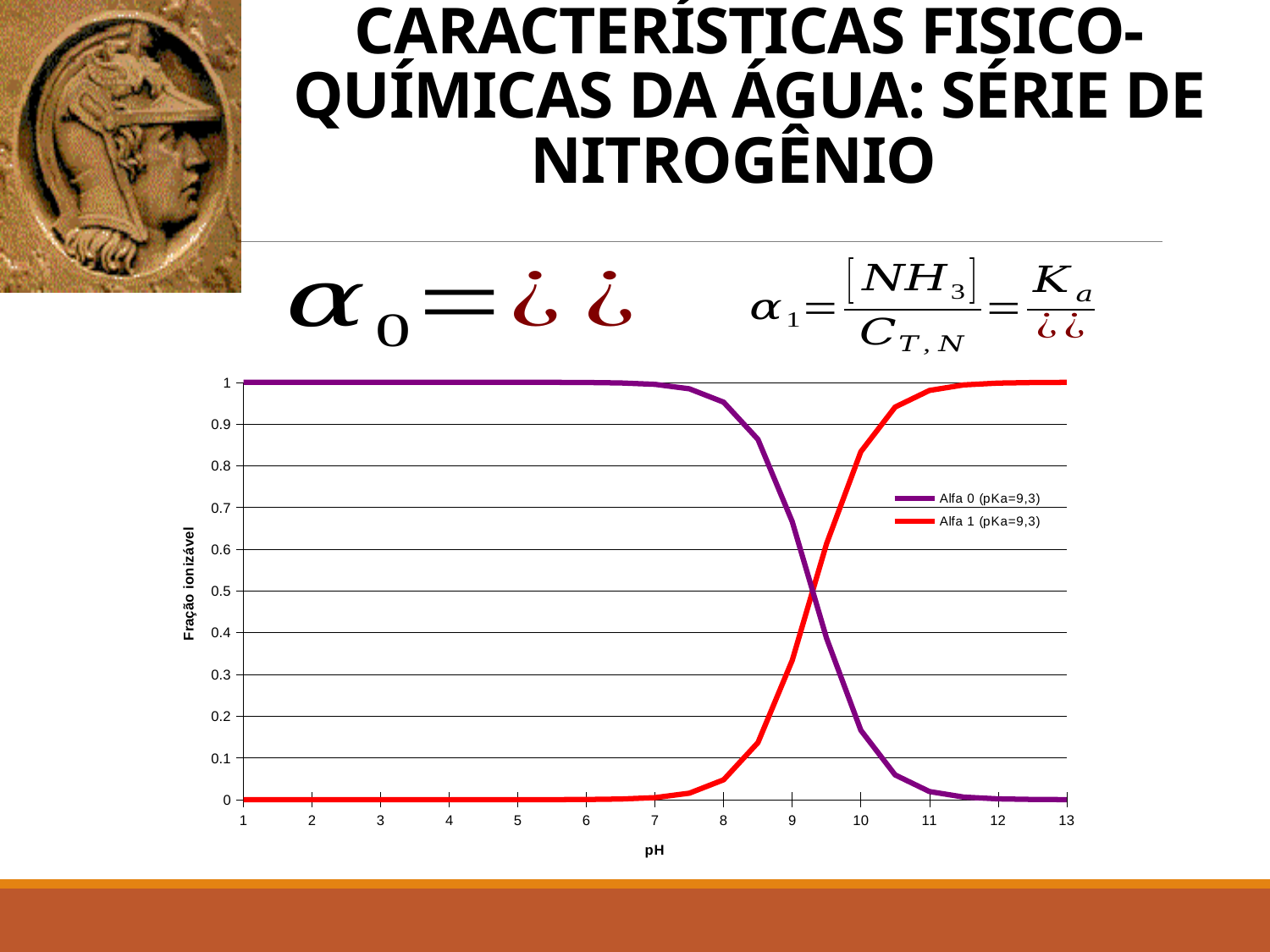
Does the Alfa 1 (pKa=9,3) series rise or fall as pH increases? rise At pH 8, which series has the larger value, Alfa 0 (pKa=9,3) or Alfa 1 (pKa=9,3)? Alfa 0 (pKa=9,3) What is the label of the chart's y axis? Fração ionizável What kind of chart is shown on the slide? line chart Is the value of Alfa 0 (pKa=9,3) at pH 10 greater or less than 0.2? less What is the label of the chart's x axis? pH Is the value of Alfa 1 (pKa=9,3) at pH 10 greater or less than 0.8? greater What is the value of Alfa 1 (pKa=9,3) at pH 1? 0 Is the value of Alfa 0 (pKa=9,3) at pH 8 greater or less than 0.9? greater Does the Alfa 0 (pKa=9,3) series rise or fall as pH increases? fall How many series does the chart legend list? 2 What is the value of Alfa 0 (pKa=9,3) at pH 1? 1